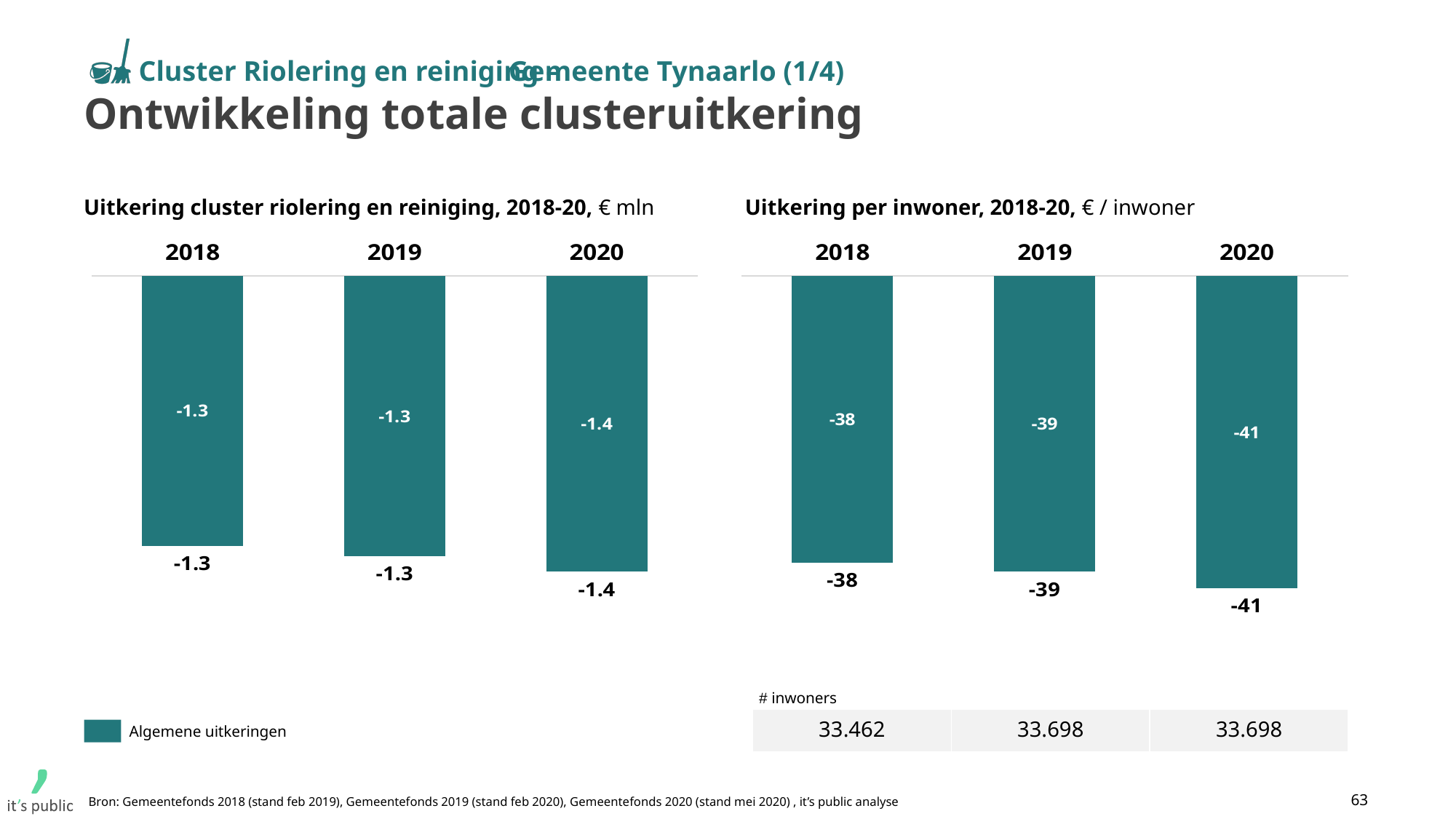
In the chart 'Uitkering cluster riolering en reiniging, 2018-20', what is the difference between the values for 2019 and 2020? 0.1 In the chart 'Uitkering per inwoner, 2018-20', what is the value for 2020? -41 In the chart 'Uitkering per inwoner, 2018-20', what is the value for 2019? -39 In the chart 'Uitkering cluster riolering en reiniging, 2018-20', what is the value for 2020? -1.4 In the chart 'Uitkering per inwoner, 2018-20', which year has the lowest value? 2020 In the chart 'Uitkering per inwoner, 2018-20', do the values rise or fall from 2018 to 2020? fall In the chart 'Uitkering per inwoner, 2018-20', which year has the highest value? 2018 In the chart 'Uitkering cluster riolering en reiniging, 2018-20', which year has the lowest value? 2020 In the chart 'Uitkering cluster riolering en reiniging, 2018-20', what is the value for 2018? -1.3 How many years are shown in the chart 'Uitkering cluster riolering en reiniging, 2018-20'? 3 What kind of chart is 'Uitkering per inwoner, 2018-20'? bar chart In the chart 'Uitkering per inwoner, 2018-20', what is the difference between the values for 2018 and 2020? 3